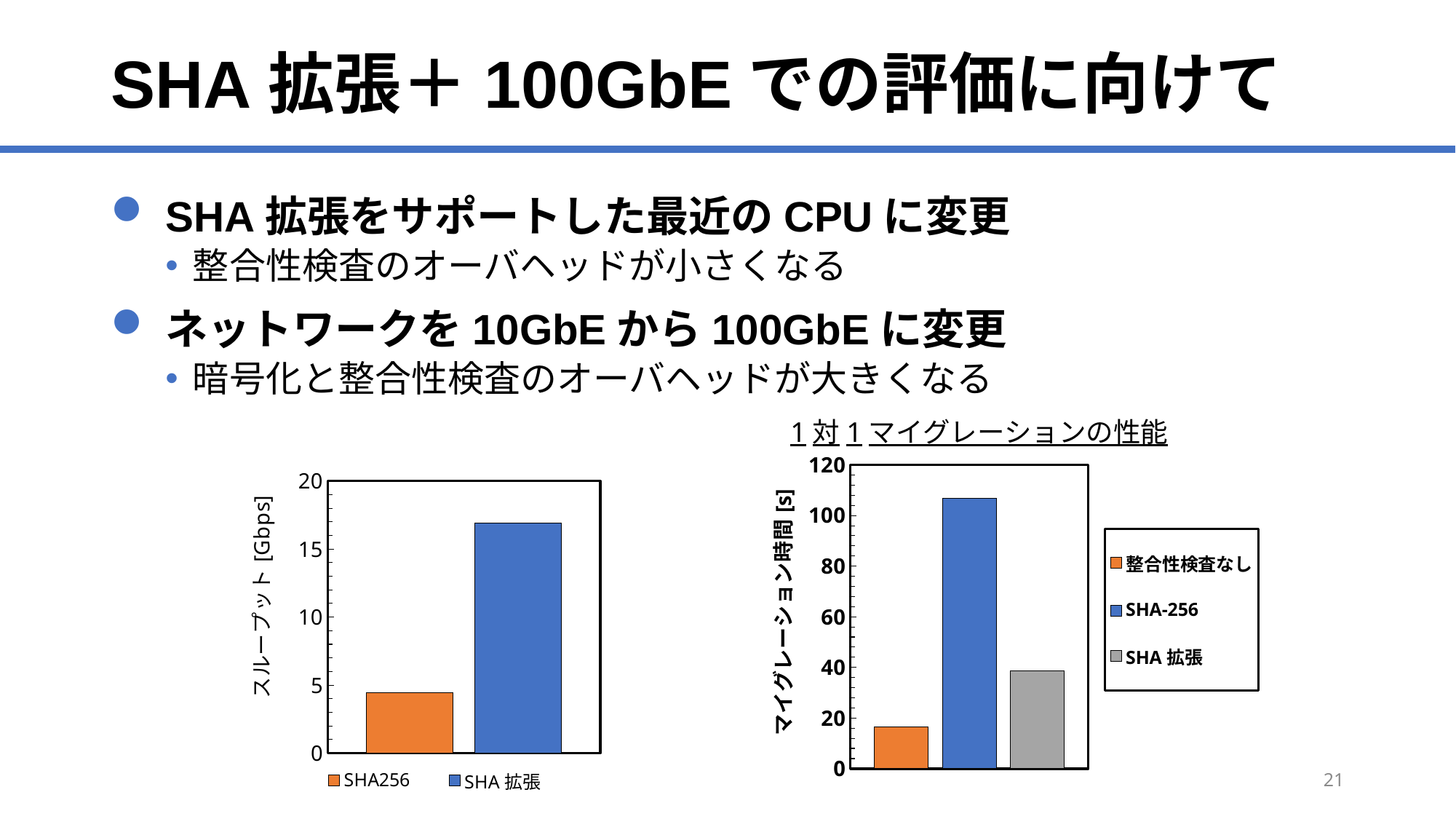
What is the y-axis label of the left chart? スループット [Gbps] In the right chart titled 1対1マイグレーションの性能, which series has the longest migration time? SHA-256 In the left chart (throughput chart), is the value for SHA256 greater or less than 5? less In the right chart titled 1対1マイグレーションの性能, is the value for SHA-256 greater or less than 100? greater In the left chart (throughput chart), which series has the higher throughput, SHA256 or SHA 拡張? SHA 拡張 In the right chart titled 1対1マイグレーションの性能, which series has the shortest migration time? 整合性検査なし In the right chart titled 1対1マイグレーションの性能, how many series does the legend list? 3 What kind of chart is the left chart (throughput chart)? bar chart In the left chart (throughput chart), how many series does the legend list? 2 What kind of chart is the right chart titled 1対1マイグレーションの性能? bar chart In the left chart (throughput chart), is the value for SHA 拡張 greater or less than 15? greater